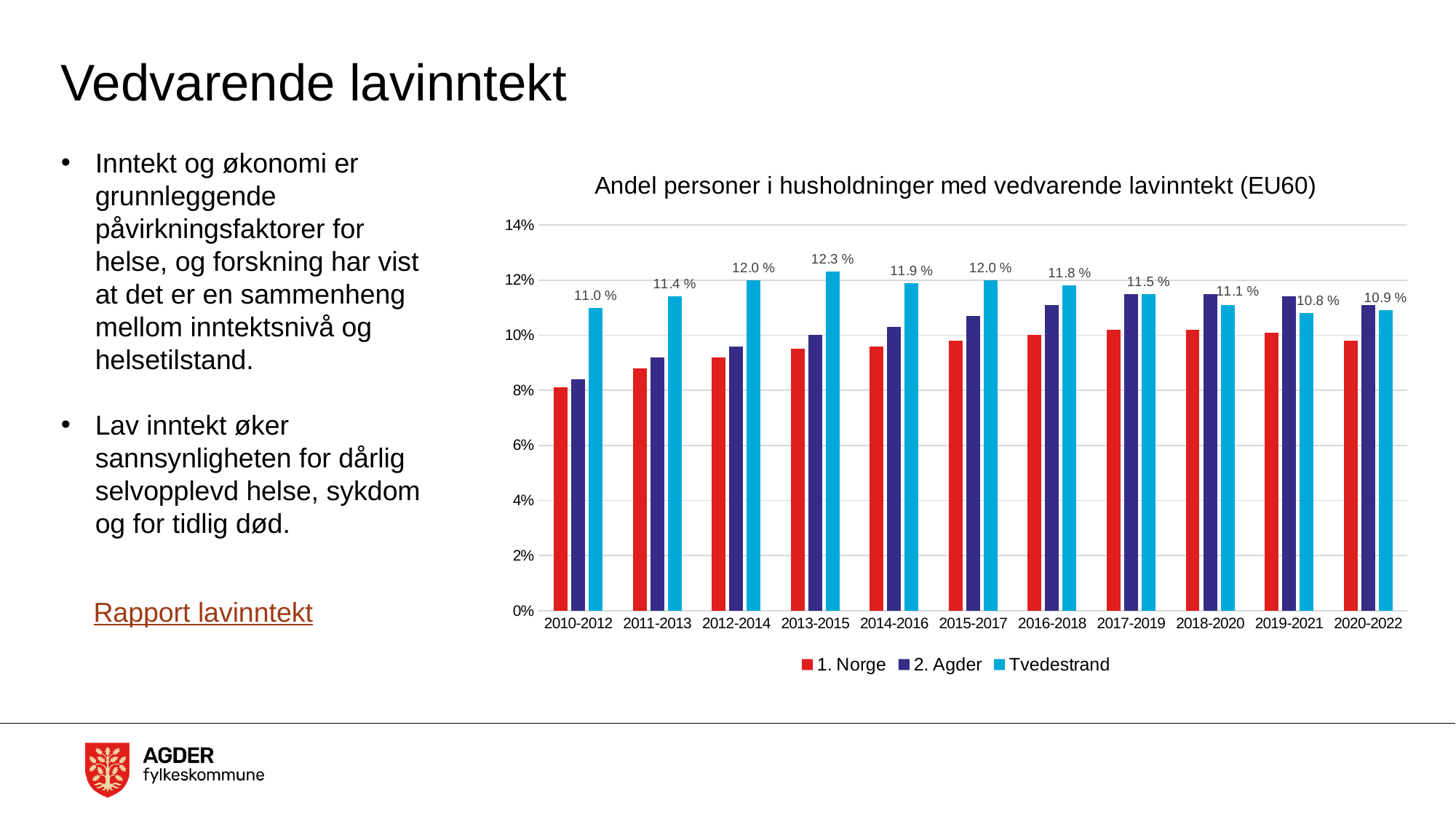
How many series does the legend list? 3 What is the title of the chart? Andel personer i husholdninger med vedvarende lavinntekt (EU60) In which period is the Tvedestrand value highest? 2013-2015 Does the Tvedestrand value rise or fall from 2013-2015 to 2019-2021? fall In 2010-2012, which is larger: the value for 1. Norge or for Tvedestrand? Tvedestrand In which period is the Tvedestrand value lowest? 2019-2021 Is the value for 1. Norge in 2010-2012 greater or less than 10%? less What is the difference between the Tvedestrand values for 2013-2015 and 2019-2021? 1.5 percentage points What is the value for Tvedestrand in 2013-2015? 12.3 % What is the value for Tvedestrand in 2019-2021? 10.8 % What type of chart is shown on the slide? bar chart How many periods are shown on the x axis? 11